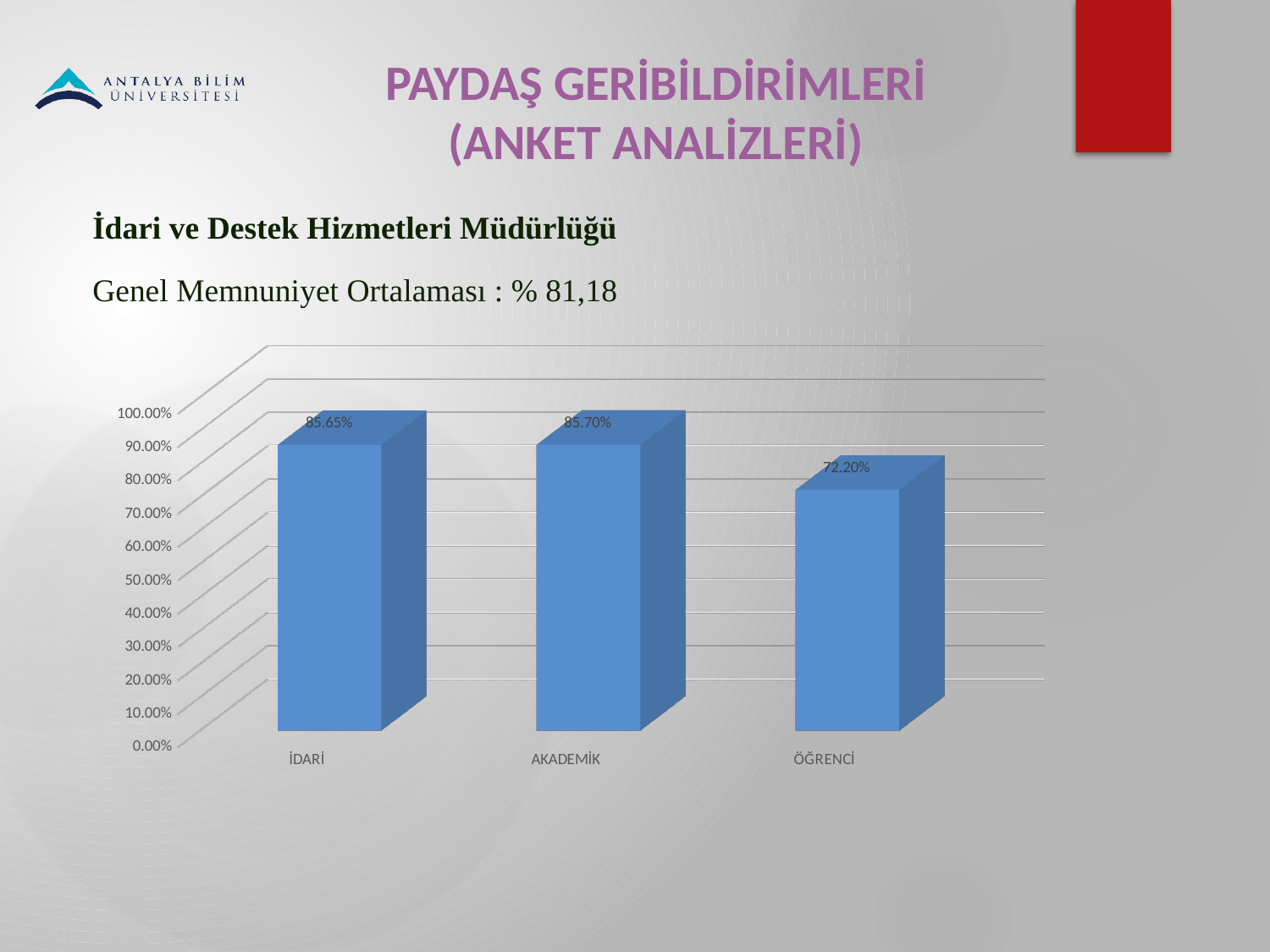
What is the Genel Memnuniyet Ortalaması stated above the chart? % 81,18 What is the difference between the values for AKADEMİK and ÖĞRENCİ? 13.50% What kind of chart is shown on the slide? bar chart Which category has the lowest value? ÖĞRENCİ How many categories are shown on the x axis? 3 What is the value for İDARİ? 85.65% Is the value for ÖĞRENCİ greater or less than 80.00%? less Which is larger, the value for İDARİ or the value for ÖĞRENCİ? İDARİ Which category has the highest value according to the data labels? AKADEMİK What is the difference between the values for İDARİ and ÖĞRENCİ? 13.45% What is the value for ÖĞRENCİ? 72.20% What is the value for AKADEMİK? 85.70%